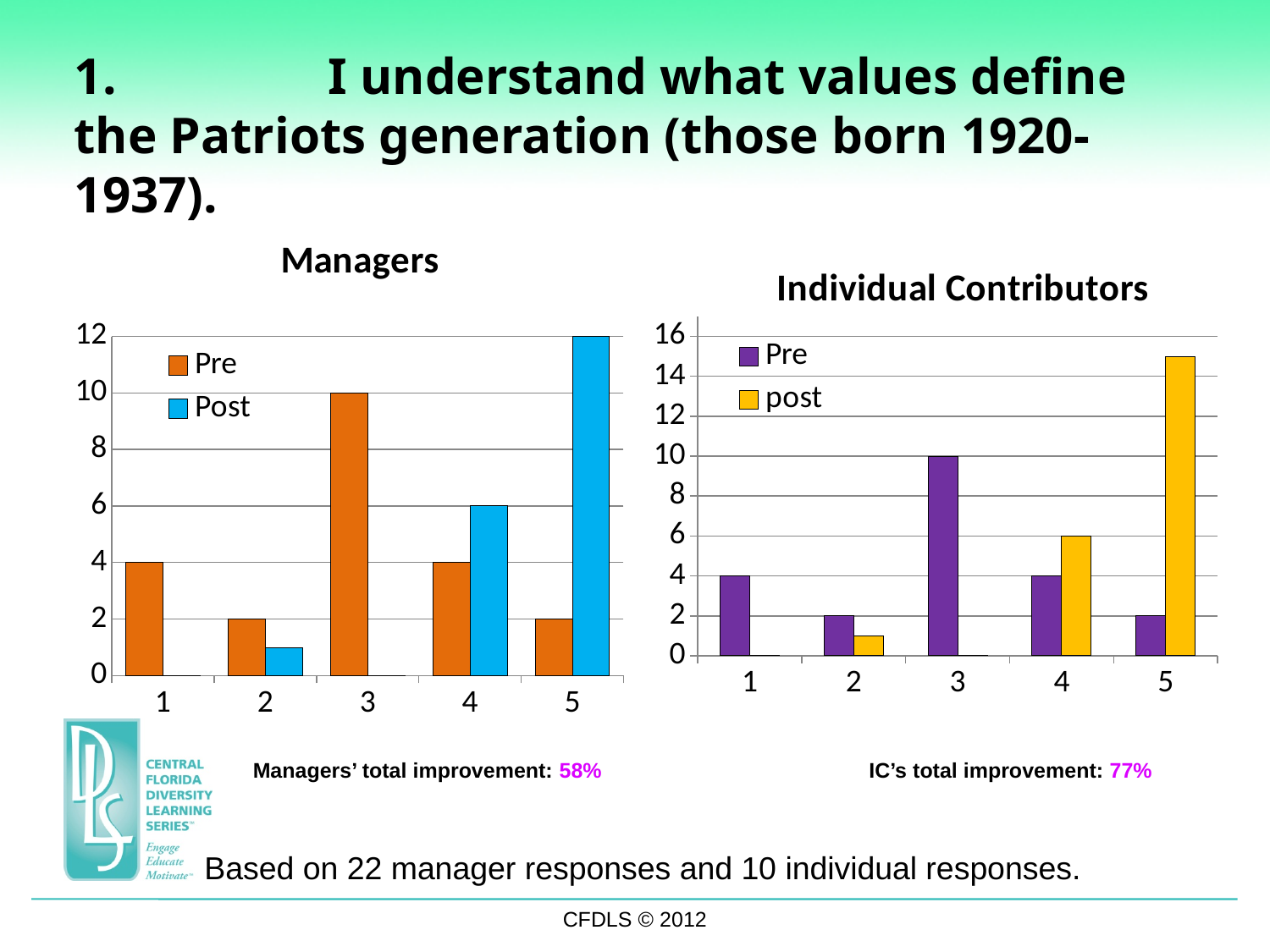
In the Individual Contributors chart, is the Pre value for category 4 larger or the post value for category 4? post In the Managers chart, which category has the highest Post value? 5 In the Individual Contributors chart, which category has the highest post value? 5 What type of chart is the Individual Contributors chart? Bar chart In the Individual Contributors chart, what is the Pre value for category 3? 10 In the Managers chart, what is the Post value for category 4? 6 In the Managers chart, what is the Pre value for category 3? 10 In the Individual Contributors chart, is the post value for category 5 greater or less than 14? greater How many series does the legend of the Managers chart list? 2 In the Managers chart, which category has the highest Pre value? 3